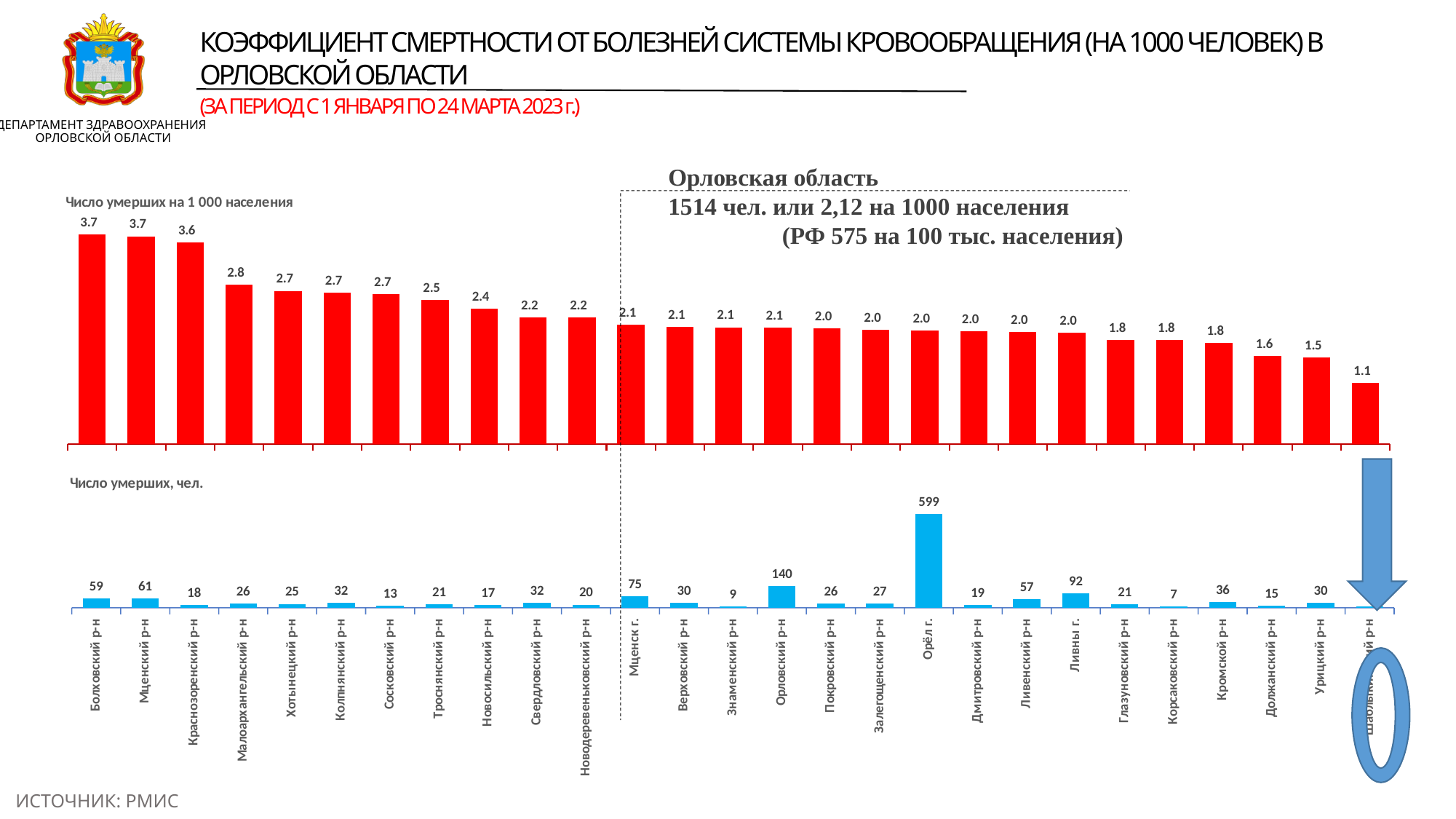
In the top chart (Число умерших на 1 000 населения), what is the value for Орёл г.? 2.0 In the top chart (Число умерших на 1 000 населения), do the values rise or fall from left to right along the x axis? fall In the top chart (Число умерших на 1 000 населения), which is larger: the value for Малоархангельский р-н or the value for Должанский р-н? Малоархангельский р-н What kind of chart is the top chart (Число умерших на 1 000 населения)? bar chart In the top chart (Число умерших на 1 000 населения), what is the value for Краснозоренский р-н? 3.6 In the bottom chart (Число умерших, чел.), which category has the highest value? Орёл г. How many categories (districts and cities) are shown on the x axis of the charts? 27 In the bottom chart (Число умерших, чел.), which is larger: the value for Мценск г. or the value for Верховский р-н? Мценск г. In the bottom chart (Число умерших, чел.), what is the difference between the values for Орёл г. and Ливны г.? 507 In the top chart (Число умерших на 1 000 населения), what is the difference between the values for Болховский р-н and Урицкий р-н? 2.2 In the bottom chart (Число умерших, чел.), what is the value for Орловский р-н? 140